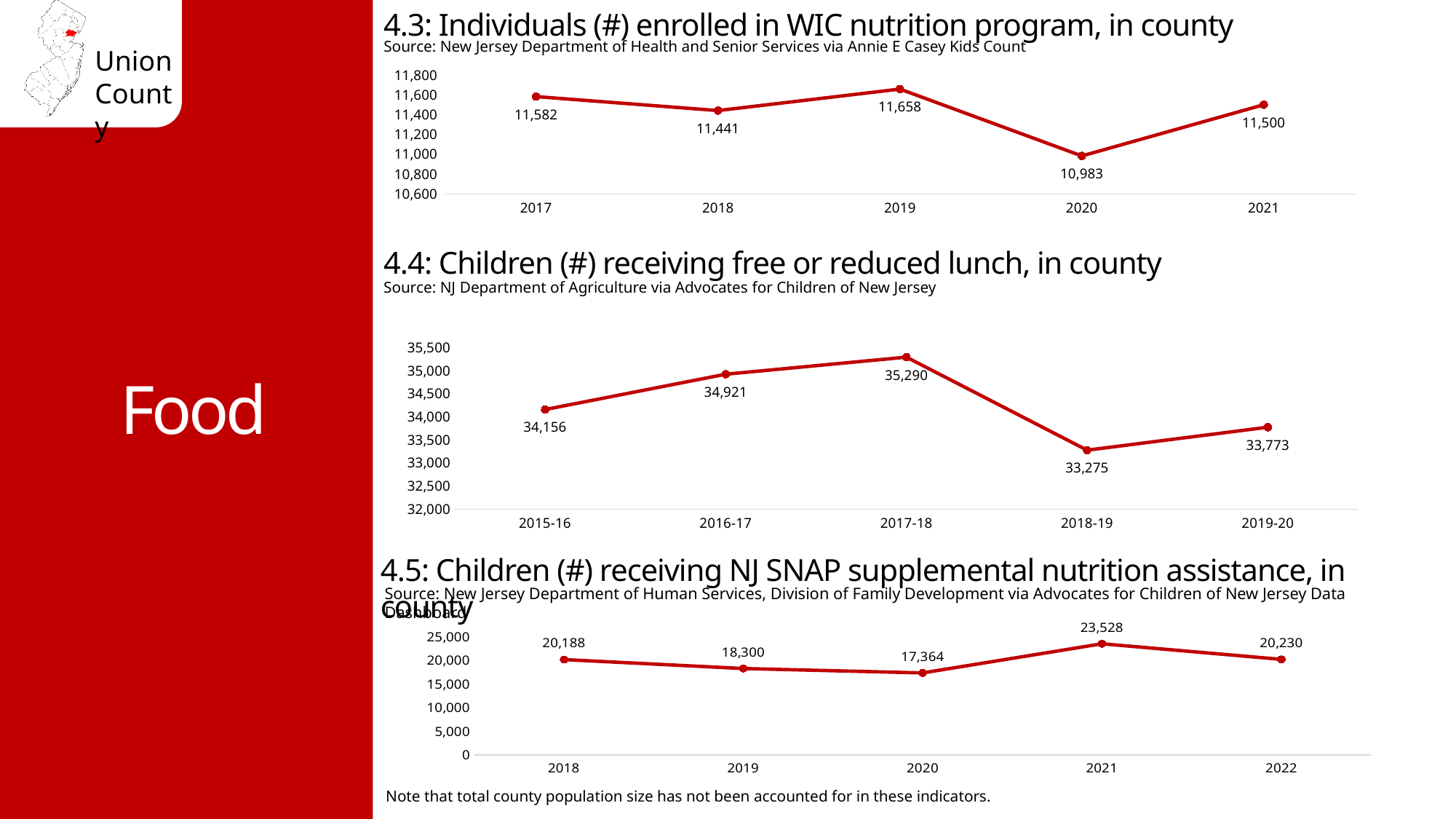
What kind of chart is '4.5: Children (#) receiving NJ SNAP supplemental nutrition assistance, in county'? line chart In the chart '4.4: Children (#) receiving free or reduced lunch, in county', which school year has the highest value? 2017-18 In the chart '4.4: Children (#) receiving free or reduced lunch, in county', do the values rise or fall from 2015-16 to 2017-18? rise In the chart '4.4: Children (#) receiving free or reduced lunch, in county', is the value for 2015-16 larger or smaller than the value for 2019-20? larger In the chart '4.3: Individuals (#) enrolled in WIC nutrition program, in county', how many years are plotted? 5 In the chart '4.3: Individuals (#) enrolled in WIC nutrition program, in county', what is the value for 2019? 11,658 In the chart '4.5: Children (#) receiving NJ SNAP supplemental nutrition assistance, in county', what is the value for 2021? 23,528 In the chart '4.4: Children (#) receiving free or reduced lunch, in county', what is the value for 2018-19? 33,275 In the chart '4.5: Children (#) receiving NJ SNAP supplemental nutrition assistance, in county', which year has the lowest value? 2020 In the chart '4.5: Children (#) receiving NJ SNAP supplemental nutrition assistance, in county', what is the difference between the 2021 and 2022 values? 3,298 In the chart '4.3: Individuals (#) enrolled in WIC nutrition program, in county', what is the difference between the 2017 and 2018 values? 141 In the chart '4.3: Individuals (#) enrolled in WIC nutrition program, in county', which year has the lowest value? 2020